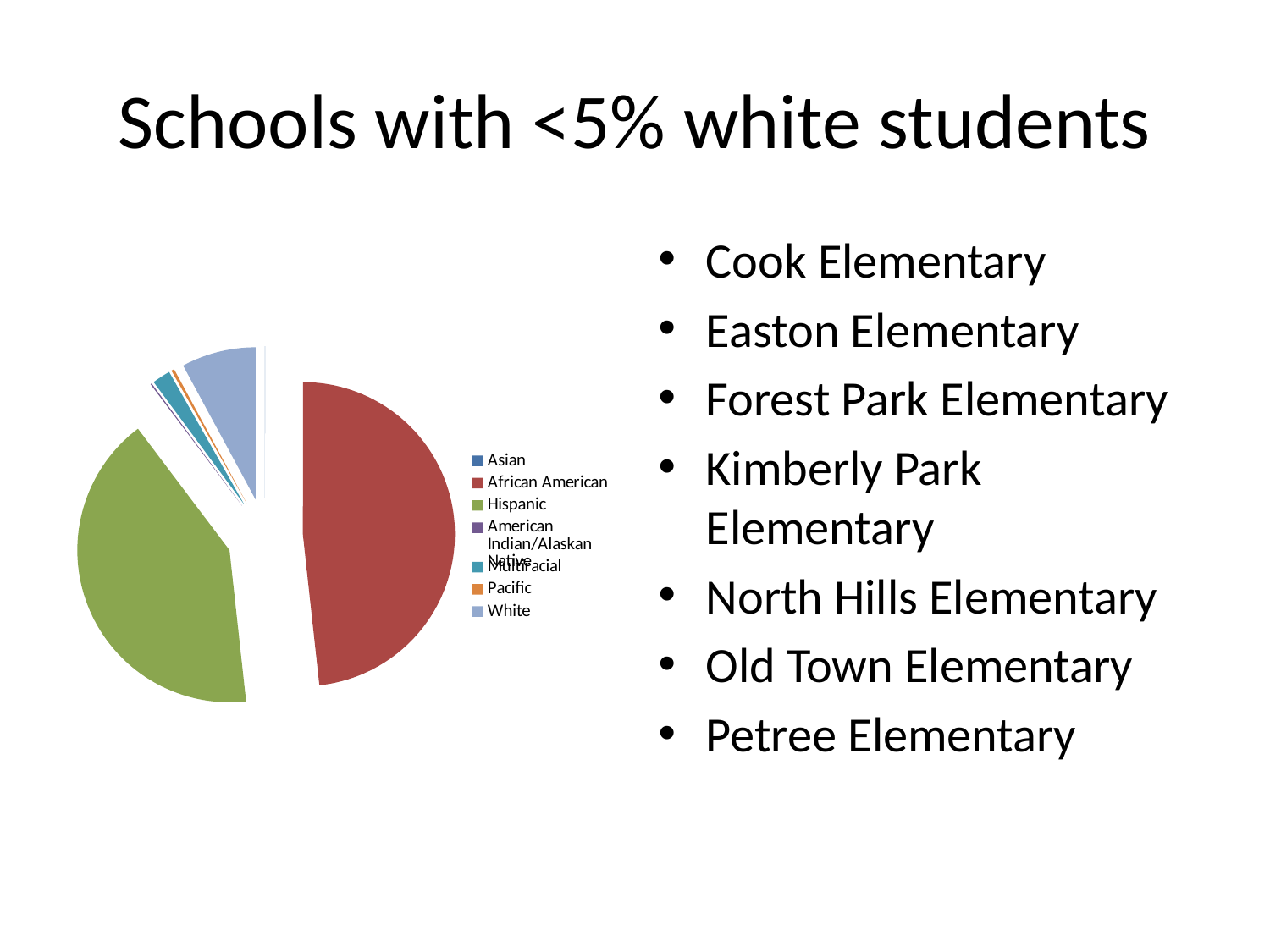
Which slice is larger in the pie chart, White or Multiracial? White Which slice is larger in the pie chart, Hispanic or Multiracial? Hispanic Which slice is larger in the pie chart, African American or Hispanic? African American Which category has the largest slice in the pie chart? African American What is the title of the slide containing the pie chart? Schools with <5% white students What colour is the Hispanic slice in the pie chart? green How many categories does the pie chart's legend list? 7 What kind of chart is shown on the slide? pie chart